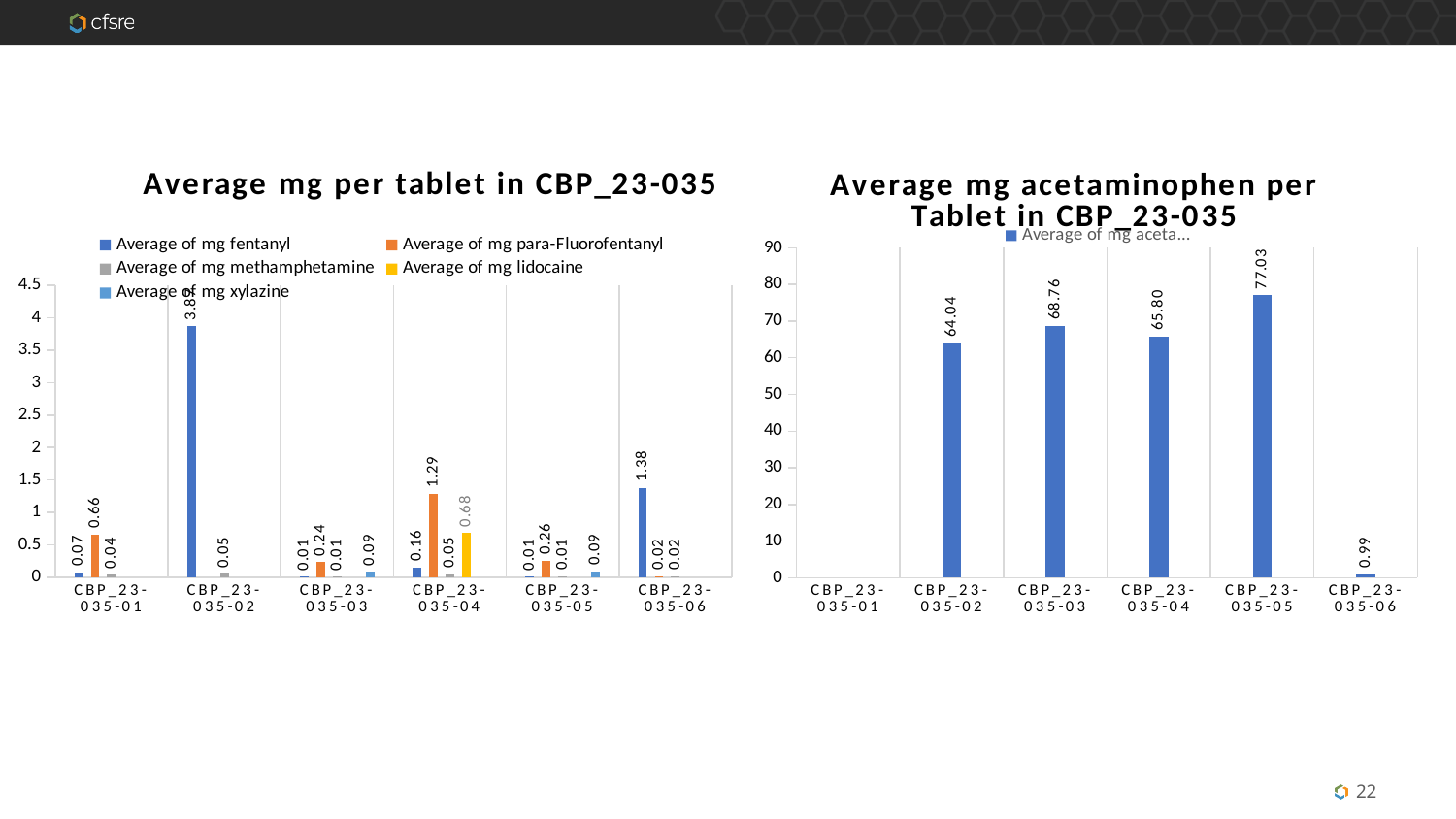
In the chart 'Average mg acetaminophen per Tablet in CBP_23-035', what is the value for CBP_23-035-06? 0.99 In the chart 'Average mg per tablet in CBP_23-035', is the Average of mg fentanyl for CBP_23-035-02 greater or less than 3.5? greater In the chart 'Average mg acetaminophen per Tablet in CBP_23-035', which category has the highest value? CBP_23-035-05 What kind of chart is 'Average mg acetaminophen per Tablet in CBP_23-035'? Bar chart In the chart 'Average mg per tablet in CBP_23-035', what is the Average of mg para-Fluorofentanyl for CBP_23-035-04? 1.29 In the chart 'Average mg per tablet in CBP_23-035', what is the Average of mg fentanyl for CBP_23-035-06? 1.38 In the chart 'Average mg acetaminophen per Tablet in CBP_23-035', is the value for CBP_23-035-04 greater or less than 60? greater In the chart 'Average mg acetaminophen per Tablet in CBP_23-035', what is the value for CBP_23-035-05? 77.03 In the chart 'Average mg per tablet in CBP_23-035', which is larger for CBP_23-035-01: Average of mg fentanyl or Average of mg para-Fluorofentanyl? Average of mg para-Fluorofentanyl In the chart 'Average mg acetaminophen per Tablet in CBP_23-035', what is the difference between the values for CBP_23-035-03 and CBP_23-035-02? 4.72 In the chart 'Average mg per tablet in CBP_23-035', what is the Average of mg lidocaine for CBP_23-035-04? 0.68 In the chart 'Average mg per tablet in CBP_23-035', how many series does the legend list? 5